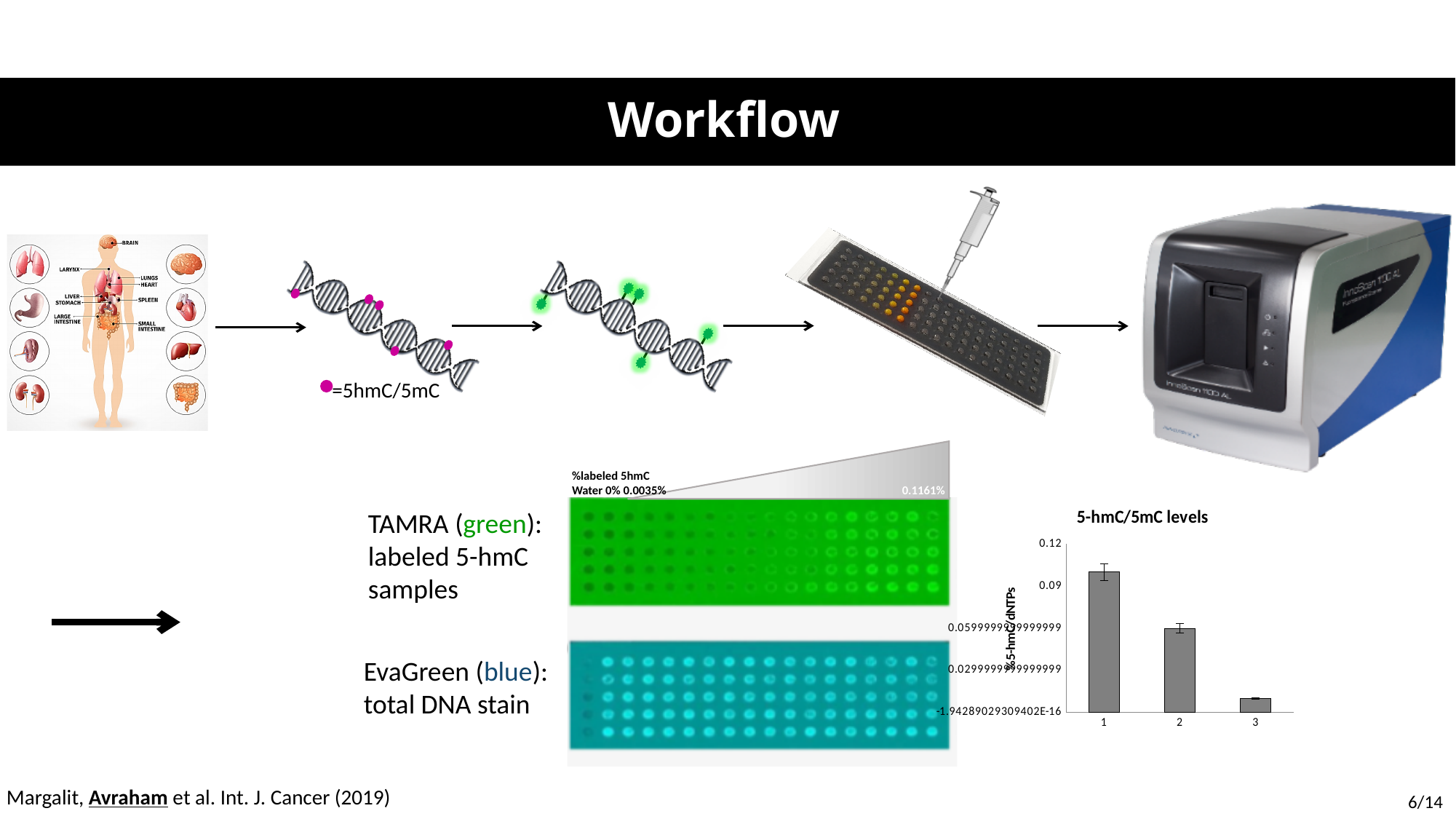
What kind of chart is the "5-hmC/5mC levels" chart? bar chart In the "5-hmC/5mC levels" chart, is the value for category 3 greater or less than 0.03? less In the "5-hmC/5mC levels" chart, which is larger, the value for category 2 or category 3? 2 What is the title of the bar chart on the slide? 5-hmC/5mC levels In the "5-hmC/5mC levels" chart, which is larger, the value for category 1 or category 2? 1 In the "5-hmC/5mC levels" chart, is the value for category 1 greater or less than 0.09? greater What is the y-axis label of the "5-hmC/5mC levels" chart? %5-hmC/dNTPs In the "5-hmC/5mC levels" chart, is the value for category 2 greater or less than 0.09? less In the "5-hmC/5mC levels" chart, which category has the lowest value? 3 In the "5-hmC/5mC levels" chart, do the values rise or fall from category 1 to category 3? fall How many bars are plotted in the "5-hmC/5mC levels" chart? 3 In the "5-hmC/5mC levels" chart, which category has the highest value? 1